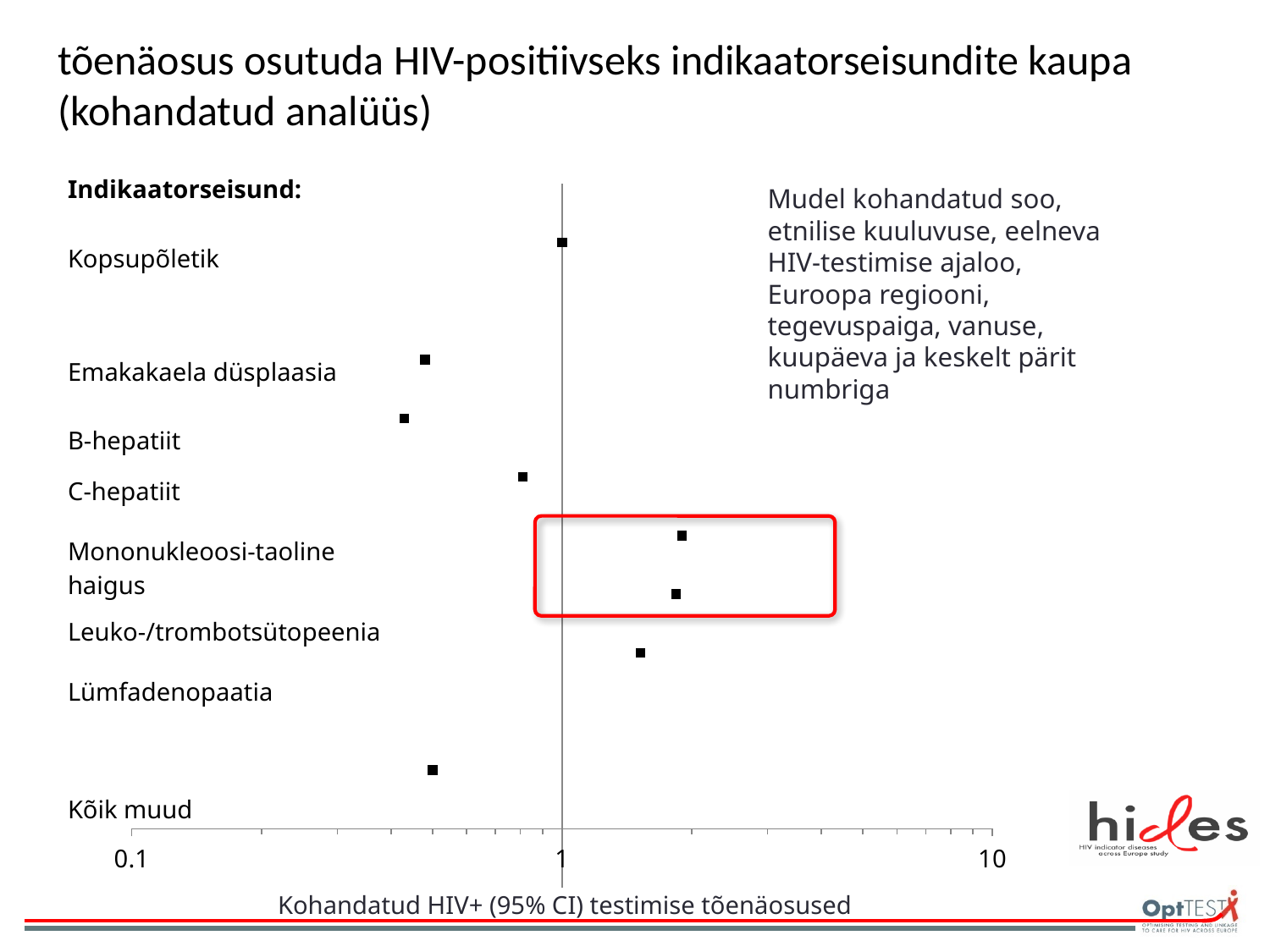
Is the value for Kõik muud greater or less than 1? less Is the value for Lümfadenopaatia greater or less than 1? greater What kind of chart is shown on the slide? scatter (dot) plot Is the value for Emakakaela düsplaasia greater or less than 1? less What is the label of the x axis? Kohandatud HIV+ (95% CI) testimise tõenäosused How many indicator conditions are plotted on the chart? 8 What are the tick values shown on the x axis? 0.1, 1, 10 Which has the larger value, Kopsupõletik or B-hepatiit? Kopsupõletik Which has the larger value, Lümfadenopaatia or C-hepatiit? Lümfadenopaatia